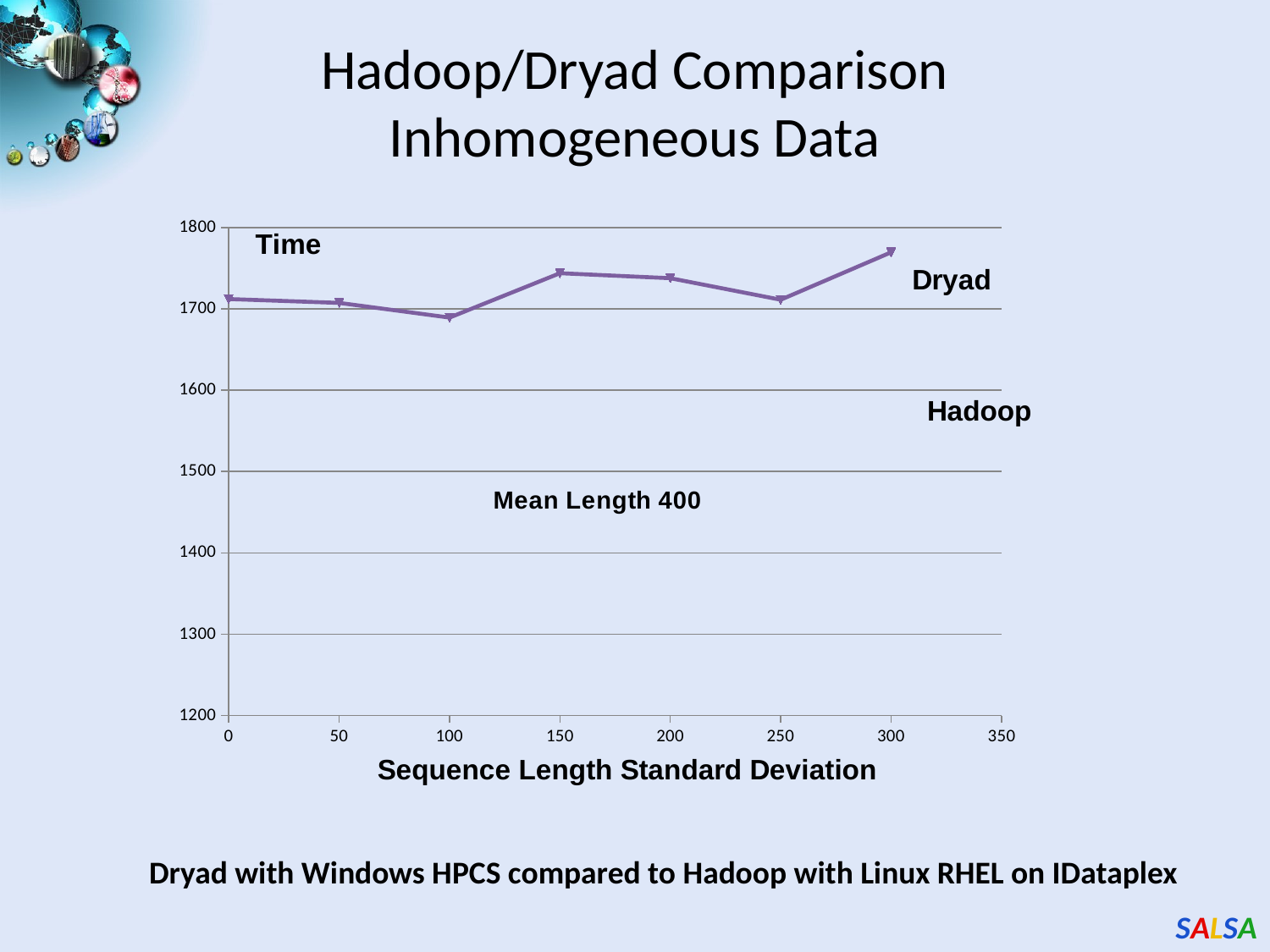
Is the value at a sequence length standard deviation of 300 greater or less than 1700? greater What kind of chart is shown on the slide? line chart At which sequence length standard deviation is the plotted time highest? 300 Is the value at a sequence length standard deviation of 100 greater or less than 1700? less Which is larger, the value at a standard deviation of 300 or the value at a standard deviation of 100? 300 Does the plotted line rise or fall between a standard deviation of 250 and 300? rise How many data points are plotted on the line? 7 Is the value at a sequence length standard deviation of 150 greater or less than 1700? greater What is the title of the x axis? Sequence Length Standard Deviation Does the plotted line rise or fall between a standard deviation of 50 and 100? fall What mean length is annotated on the chart? Mean Length 400 At which sequence length standard deviation is the plotted time lowest? 100